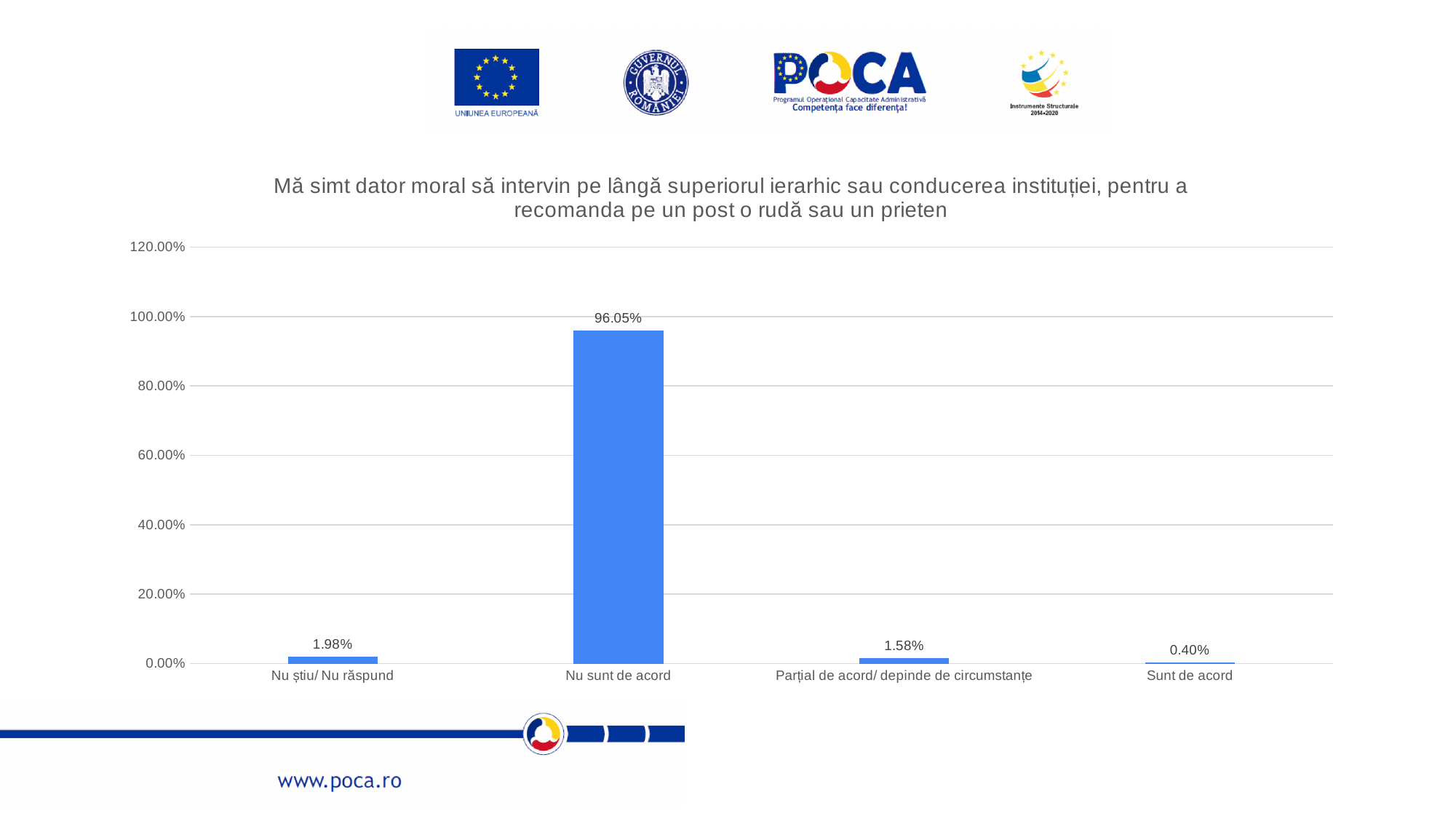
Which is larger, the value for "Nu știu/ Nu răspund" or the value for "Sunt de acord"? Nu știu/ Nu răspund What kind of chart is shown on the slide? bar chart How many categories are shown on the x axis? 4 Which category has the highest value? Nu sunt de acord What is the difference between the values for "Nu sunt de acord" and "Nu știu/ Nu răspund"? 94.07% What is the value for "Nu știu/ Nu răspund"? 1.98% What is the difference between the values for "Nu știu/ Nu răspund" and "Sunt de acord"? 1.58% What is the value for "Nu sunt de acord"? 96.05% Is the value for "Nu sunt de acord" greater or less than 80.00%? greater What is the value for "Sunt de acord"? 0.40% What is the value for "Parțial de acord/ depinde de circumstanțe"? 1.58% Which category has the lowest value? Sunt de acord